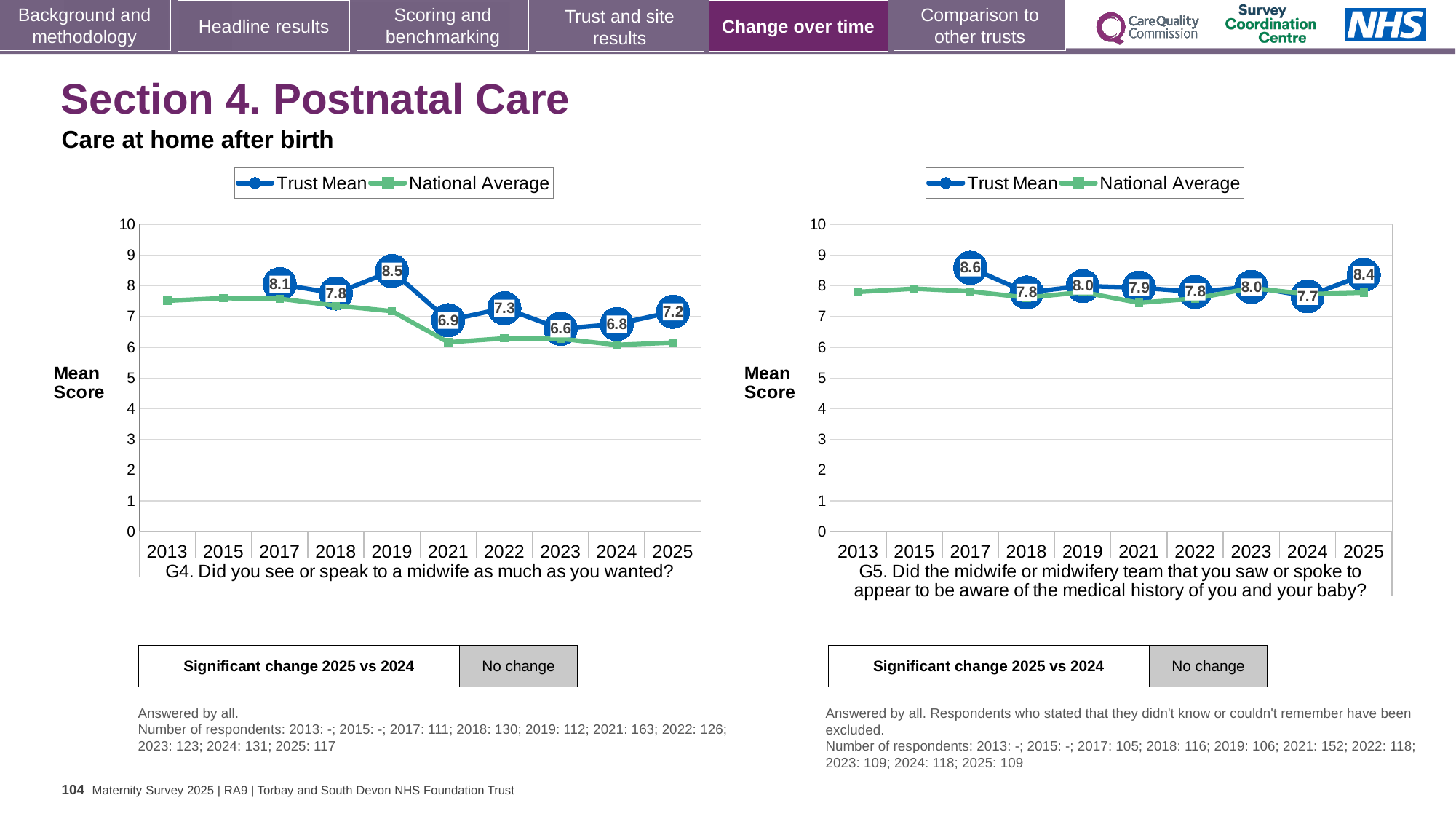
In the G5 chart (right), which is larger, the Trust Mean score for 2024 or for 2025? 2025 In the G5 chart (right), which year has the highest labelled Trust Mean score? 2017 In the G5 chart (right), what is the Trust Mean score for 2017? 8.6 How many years are shown on the x axis of the G5 chart (right)? 10 In the G4 chart (left), what is the Trust Mean score for 2025? 7.2 In the G5 chart (right), what is the difference between the Trust Mean scores for 2025 and 2024? 0.7 How many series does the legend of the G4 chart (left) list? 2 In the G4 chart (left), what is the Trust Mean score for 2019? 8.5 In the G4 chart (left), is the Trust Mean score for 2017 greater or less than 8? greater In the G4 chart (left), what is the difference between the Trust Mean scores for 2019 and 2021? 1.6 What kind of chart is the G4 chart (left)? Line chart In the G4 chart (left), which year has the lowest labelled Trust Mean score? 2023